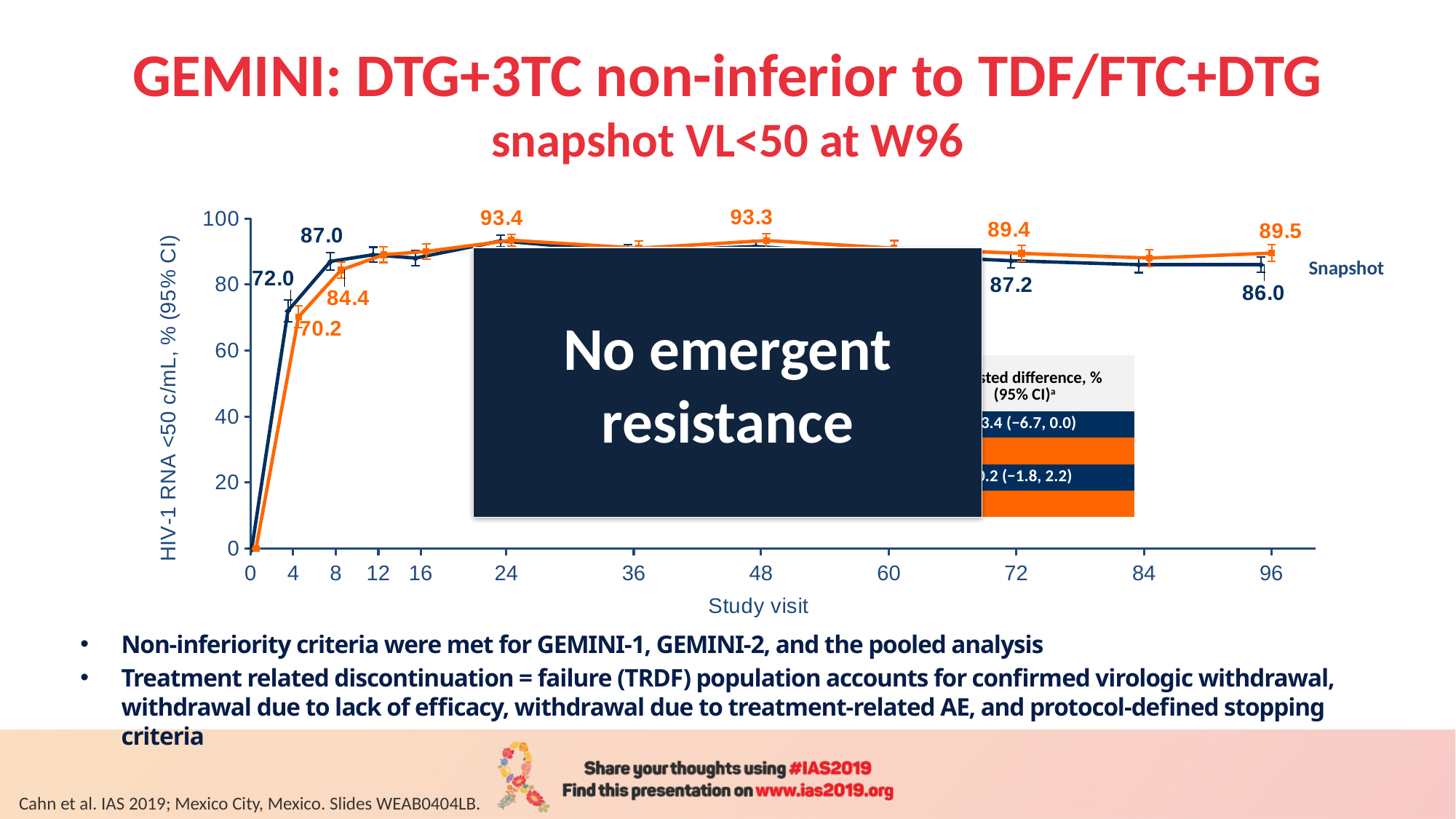
What is the value of the dark blue line at study visit week 96? 86.0 What is the value of the orange line at study visit week 4? 70.2 What is the value of the orange line at study visit week 24? 93.4 What is the difference between the dark blue and orange values at week 4? 1.8 What is the value of the orange line at study visit week 48? 93.3 What kind of chart is shown on the slide? line chart What is the title of the x axis? Study visit What is the label of the y axis? HIV-1 RNA <50 c/mL, % (95% CI) Do the values rise or fall between week 0 and week 24? rise At week 8, which line has the higher value, the dark blue or the orange? dark blue What is the difference between the orange and dark blue values at week 96? 3.5 Is the value of the dark blue line at week 36 greater or less than 80? greater